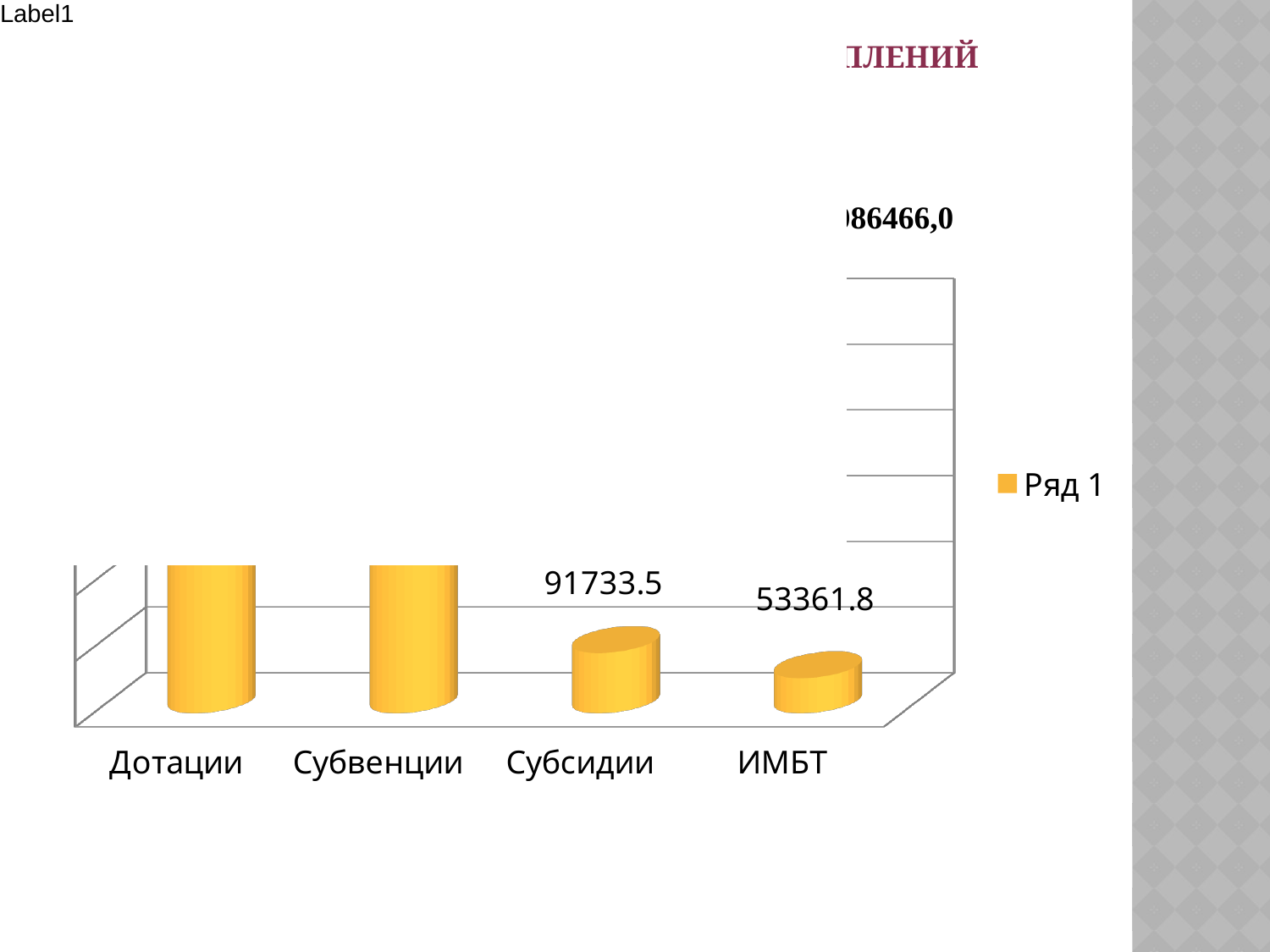
Which is larger, the value for Дотации or the value for ИМБТ? Дотации How many categories are shown on the x axis? 4 What colour are the bars in the chart? yellow What is the name of the series shown in the legend? Ряд 1 Which is larger, the value for Субсидии or the value for ИМБТ? Субсидии What is the value for Субсидии? 91733.5 How many series does the legend list? 1 What is the value for ИМБТ? 53361.8 What is the difference between the values for Субсидии and ИМБТ? 38371.7 What kind of chart is shown on the slide? bar chart Which category has the lowest value? ИМБТ